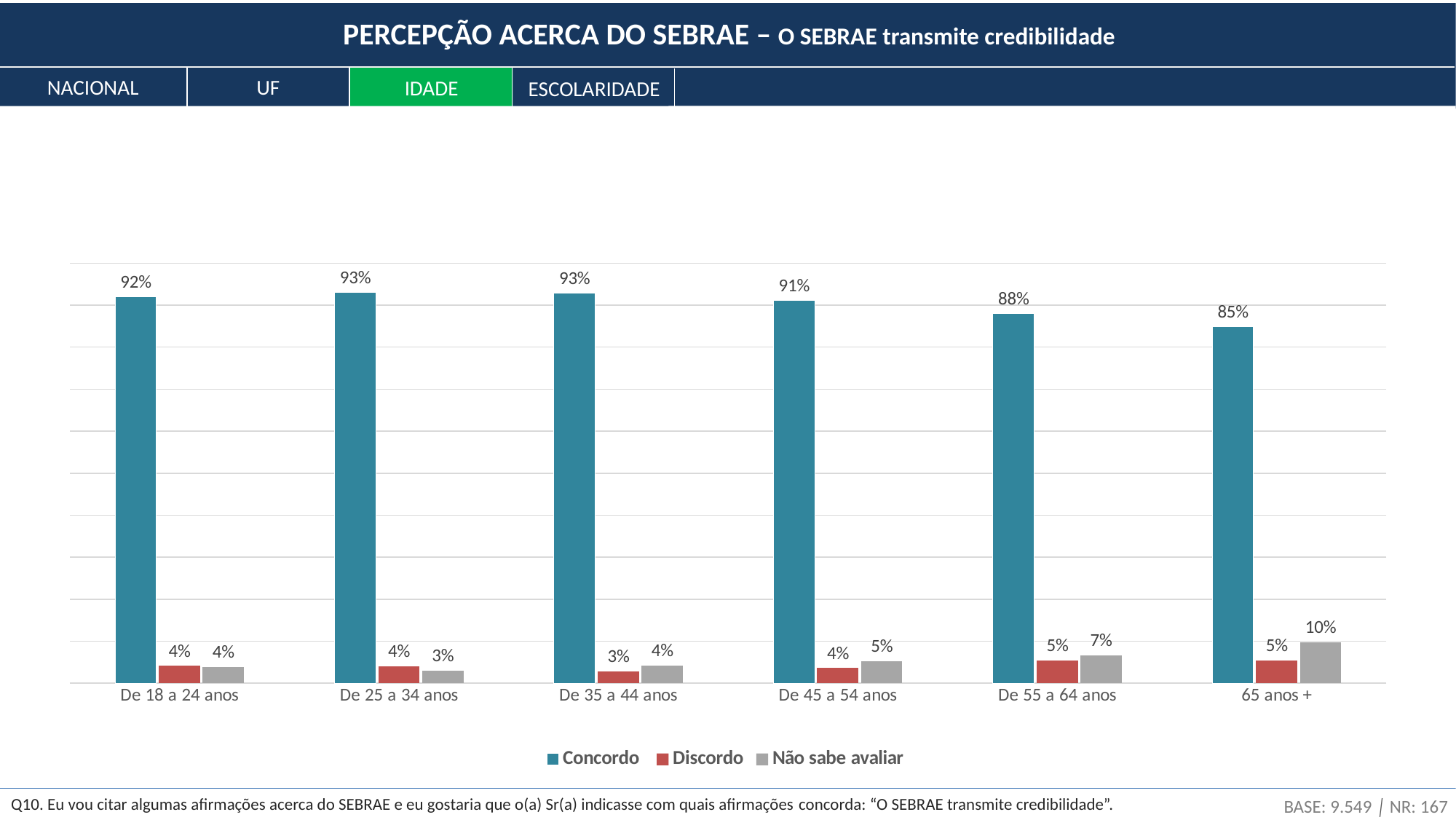
What kind of chart is shown on the slide? Bar chart Which tab is highlighted in green above the chart? IDADE Which age group has the lowest Concordo value? 65 anos + What is the Não sabe avaliar value for 65 anos +? 10% How many age groups are shown on the x axis? 6 Which is larger, the Discordo value for De 55 a 64 anos or the Discordo value for De 35 a 44 anos? De 55 a 64 anos How many series does the legend list? 3 What is the difference between the Concordo values for De 25 a 34 anos and 65 anos +? 8 percentage points Which age group has the highest Não sabe avaliar value? 65 anos + What is the Concordo value for De 18 a 24 anos? 92% What is the Discordo value for De 35 a 44 anos? 3% Does the Concordo value rise or fall from De 35 a 44 anos to 65 anos +? Fall